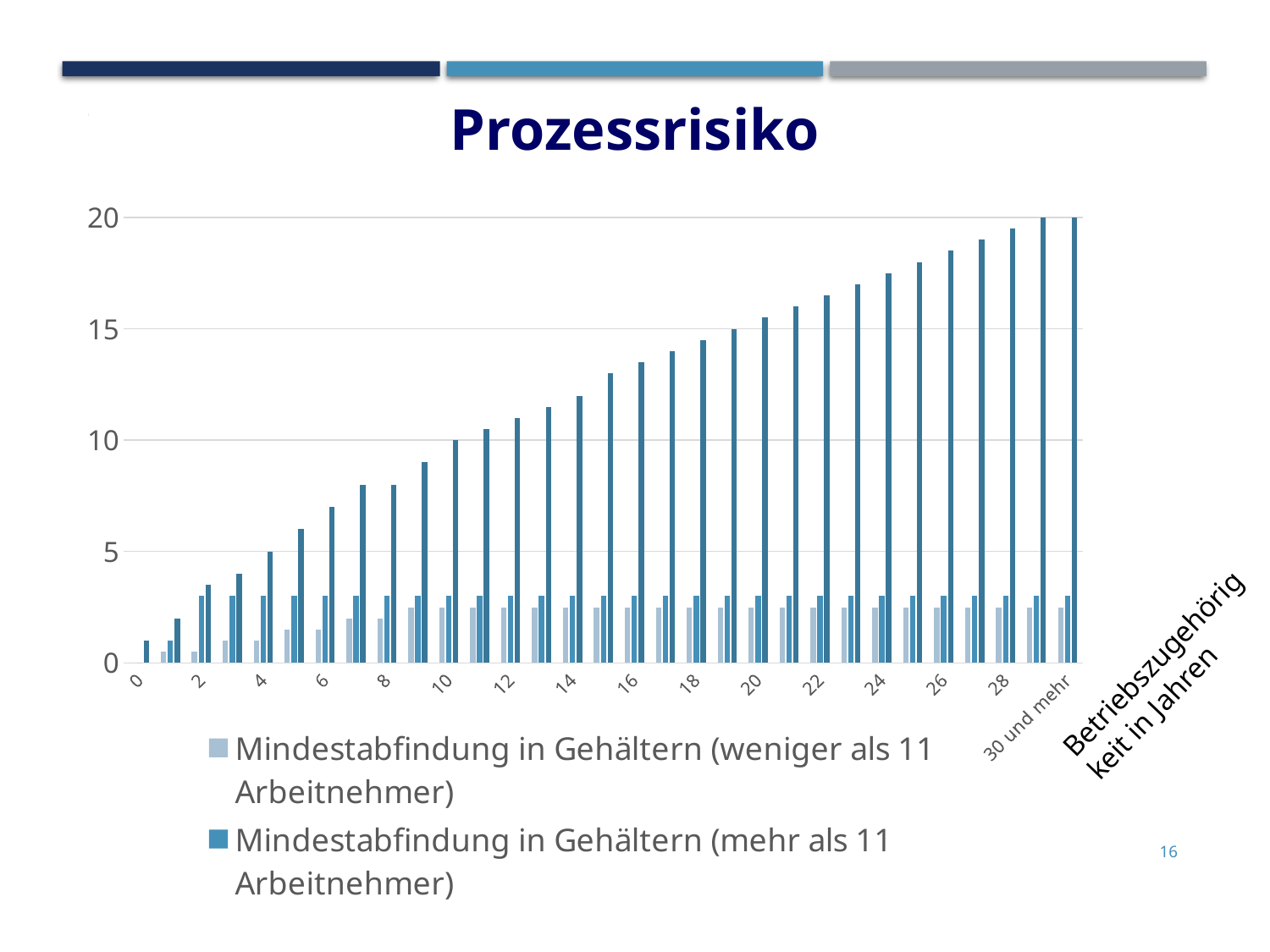
Is the tallest bar for category 4 greater or less than 10? less What is the highest value reached on the y axis by the bar for 30 und mehr? 20 Is the tallest bar for category 28 greater or less than 15? greater Which category has a taller highest bar, 10 or 20? 20 Is the tallest bar for category 20 greater or less than 10? greater What is the label of the x axis? Betriebszugehörigkeit in Jahren Which category has the lowest bars on the chart? 0 Do the tallest bars rise or fall as Betriebszugehörigkeit in Jahren increases along the x axis? rise What kind of chart is shown on the slide? bar chart How many series does the legend list? 2 What is the title of the chart? Prozessrisiko